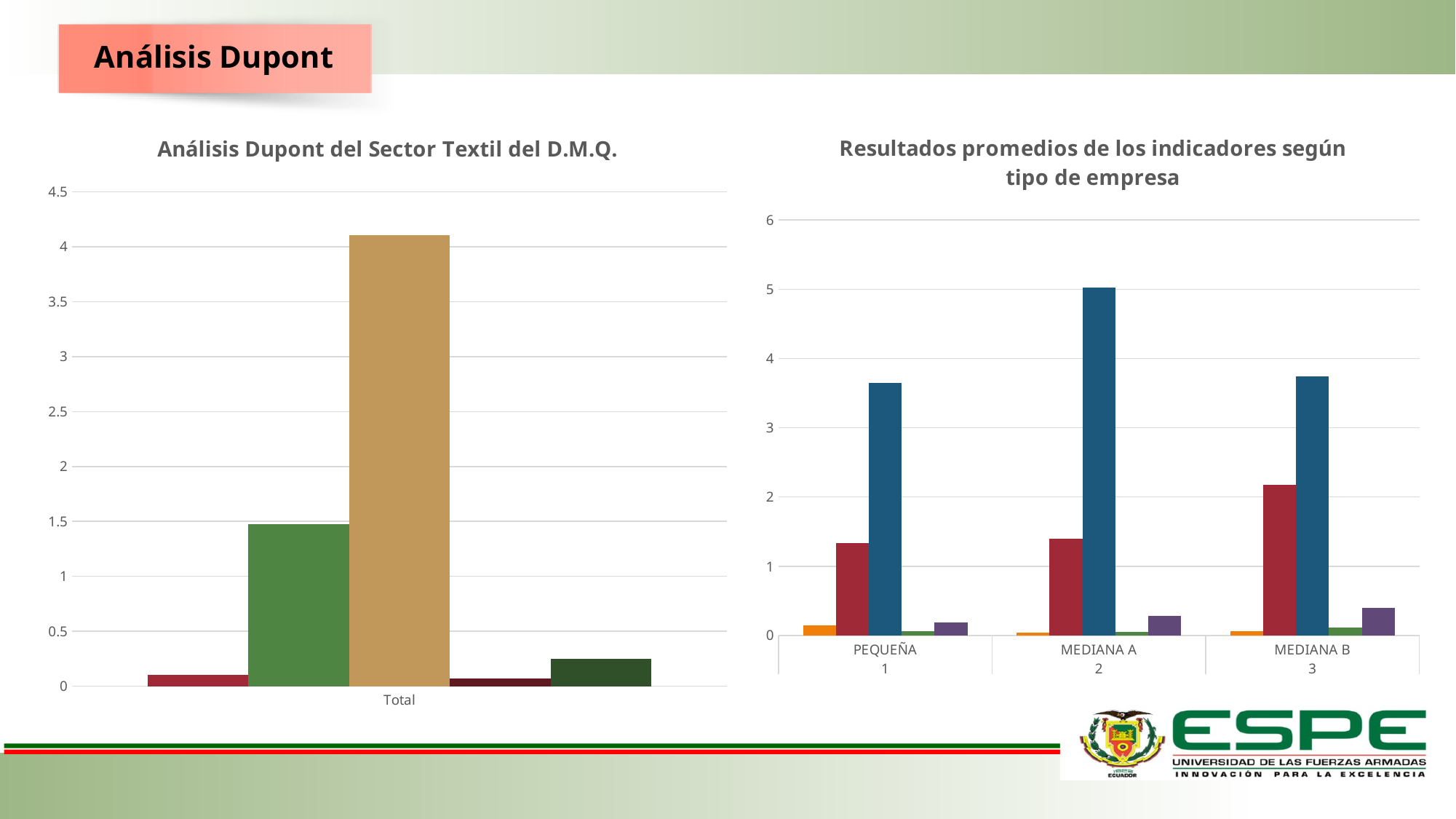
In the chart 'Análisis Dupont del Sector Textil del D.M.Q.', how many bars are plotted? 5 What kind of chart is the chart titled 'Resultados promedios de los indicadores según tipo de empresa'? bar chart In the chart 'Análisis Dupont del Sector Textil del D.M.Q.', which colour bar is the tallest? tan In the chart 'Resultados promedios de los indicadores según tipo de empresa', how many categories are shown on the x axis? 3 In the chart 'Análisis Dupont del Sector Textil del D.M.Q.', what is the label of the single category on the x axis? Total In the chart 'Resultados promedios de los indicadores según tipo de empresa', which category has the tallest blue bar? MEDIANA A In the chart 'Análisis Dupont del Sector Textil del D.M.Q.', is the value of the tallest (tan) bar greater or less than 4? greater In the chart 'Análisis Dupont del Sector Textil del D.M.Q.', is the value of the green bar greater or less than 1? greater In the chart 'Resultados promedios de los indicadores según tipo de empresa', which is larger: the red bar for PEQUEÑA or the red bar for MEDIANA B? MEDIANA B In the chart 'Resultados promedios de los indicadores según tipo de empresa', is the red bar for MEDIANA B greater or less than 2? greater What kind of chart is the chart titled 'Análisis Dupont del Sector Textil del D.M.Q.'? bar chart